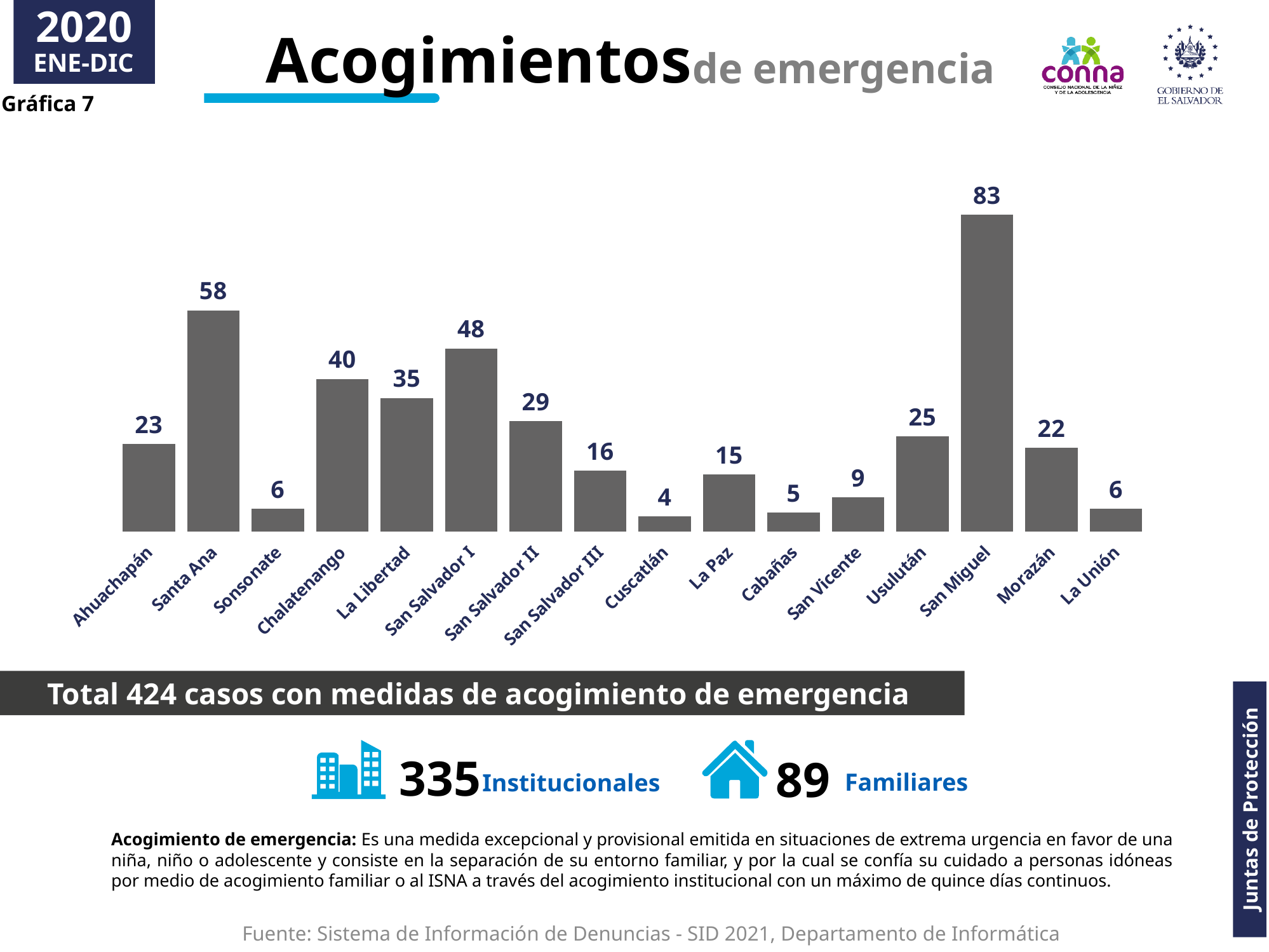
What is the title of the chart? Acogimientos de emergencia Which category has the highest value? San Miguel What kind of chart is shown on the slide? bar chart What is the value for Chalatenango? 40 Which category has the lowest value? Cuscatlán How many categories are shown on the x axis? 16 Which is larger, the value for Usulután or the value for Morazán? Usulután What is the difference between the values for San Salvador I and La Libertad? 13 Which is larger, the value for Ahuachapán or the value for San Salvador III? Ahuachapán What is the difference between the values for San Miguel and Santa Ana? 25 What is the value for San Miguel? 83 What is the value for San Salvador II? 29